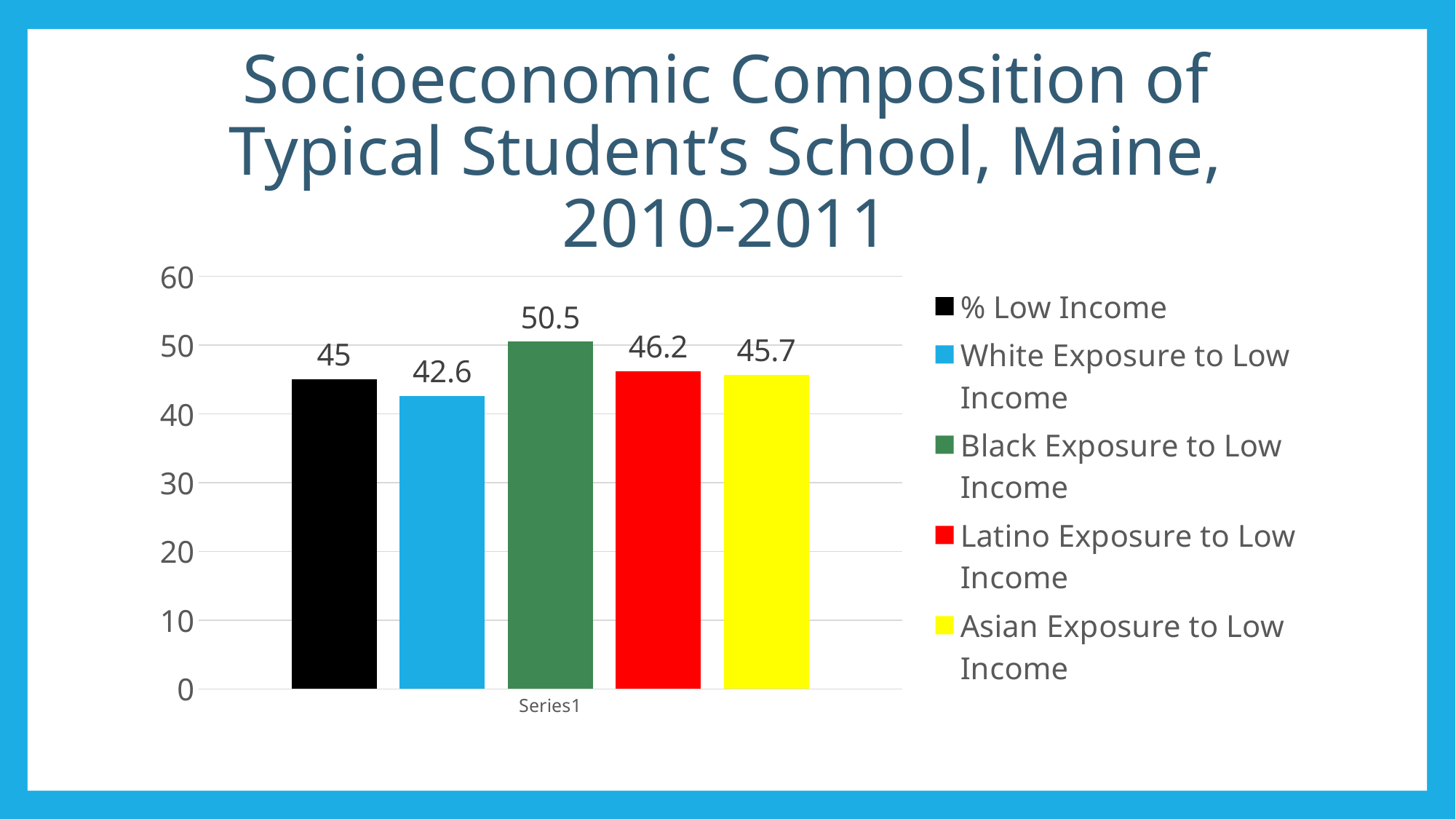
How many series does the legend list? 5 What is the value for Latino Exposure to Low Income? 46.2 Which series has the lowest value? White Exposure to Low Income What kind of chart is shown on the slide? Bar chart Which is larger, Latino Exposure to Low Income or % Low Income? Latino Exposure to Low Income What is the value for Asian Exposure to Low Income? 45.7 Which series has the highest value? Black Exposure to Low Income What is the value for % Low Income? 45 What is the value for Black Exposure to Low Income? 50.5 What is the difference between Black Exposure to Low Income and White Exposure to Low Income? 7.9 What is the value for White Exposure to Low Income? 42.6 What colour is the bar for Asian Exposure to Low Income? Yellow